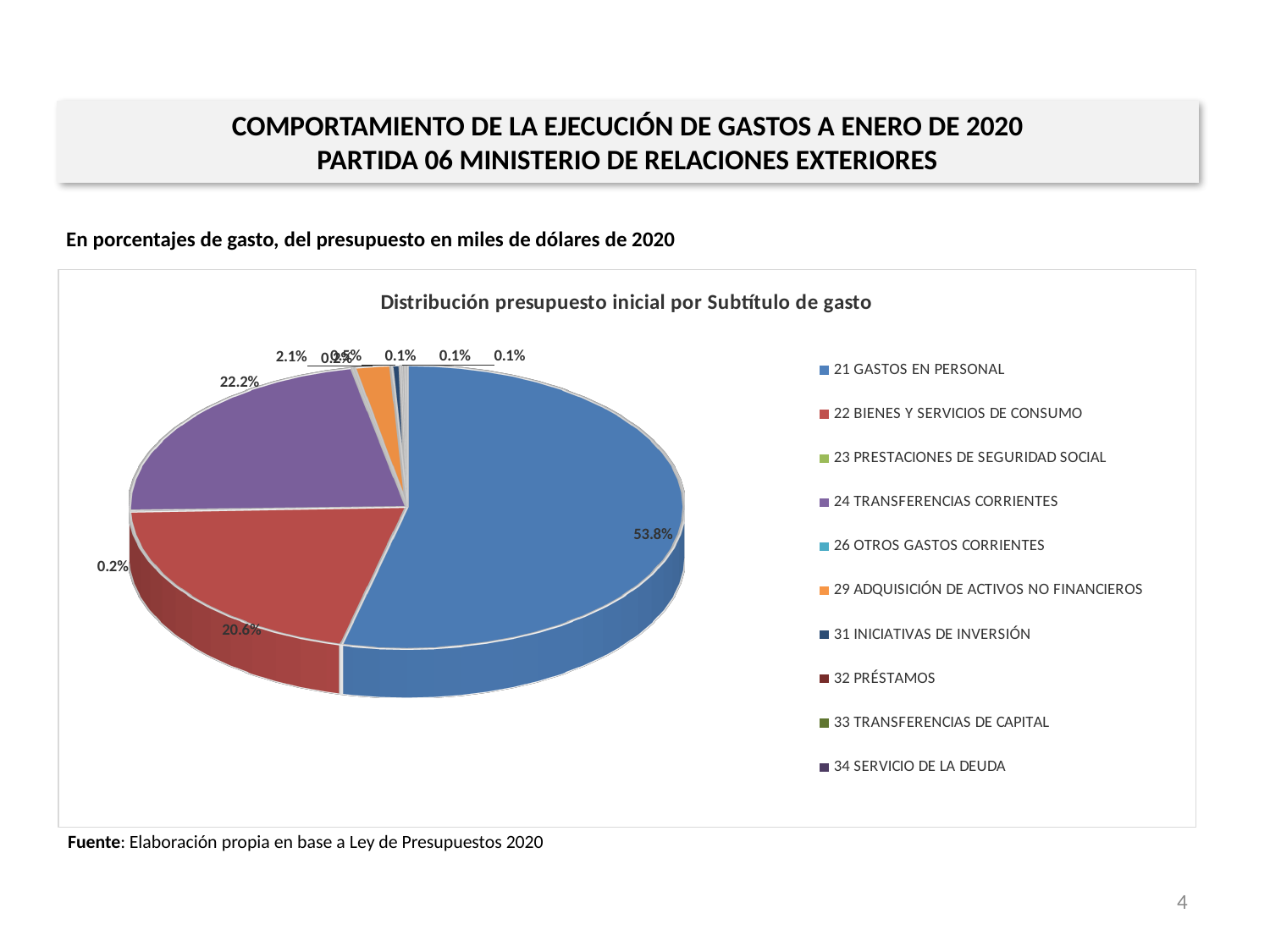
What is the combined share of 21 GASTOS EN PERSONAL and 22 BIENES Y SERVICIOS DE CONSUMO? 74.4% What kind of chart is shown on the slide? Pie chart What is the title of the chart? Distribución presupuesto inicial por Subtítulo de gasto How many entries does the chart legend list? 10 Which has a larger share: 22 BIENES Y SERVICIOS DE CONSUMO or 24 TRANSFERENCIAS CORRIENTES? 24 TRANSFERENCIAS CORRIENTES What percentage of the pie corresponds to 21 GASTOS EN PERSONAL? 53.8% What percentage of the pie corresponds to 29 ADQUISICIÓN DE ACTIVOS NO FINANCIEROS? 2.1% What is the difference in percentage points between the shares of 21 GASTOS EN PERSONAL and 24 TRANSFERENCIAS CORRIENTES? 31.6 percentage points What is the difference in percentage points between the shares of 24 TRANSFERENCIAS CORRIENTES and 22 BIENES Y SERVICIOS DE CONSUMO? 1.6 percentage points What percentage of the pie corresponds to 22 BIENES Y SERVICIOS DE CONSUMO? 20.6% What percentage of the pie corresponds to 24 TRANSFERENCIAS CORRIENTES? 22.2% Which subtítulo has the largest share of the pie? 21 GASTOS EN PERSONAL